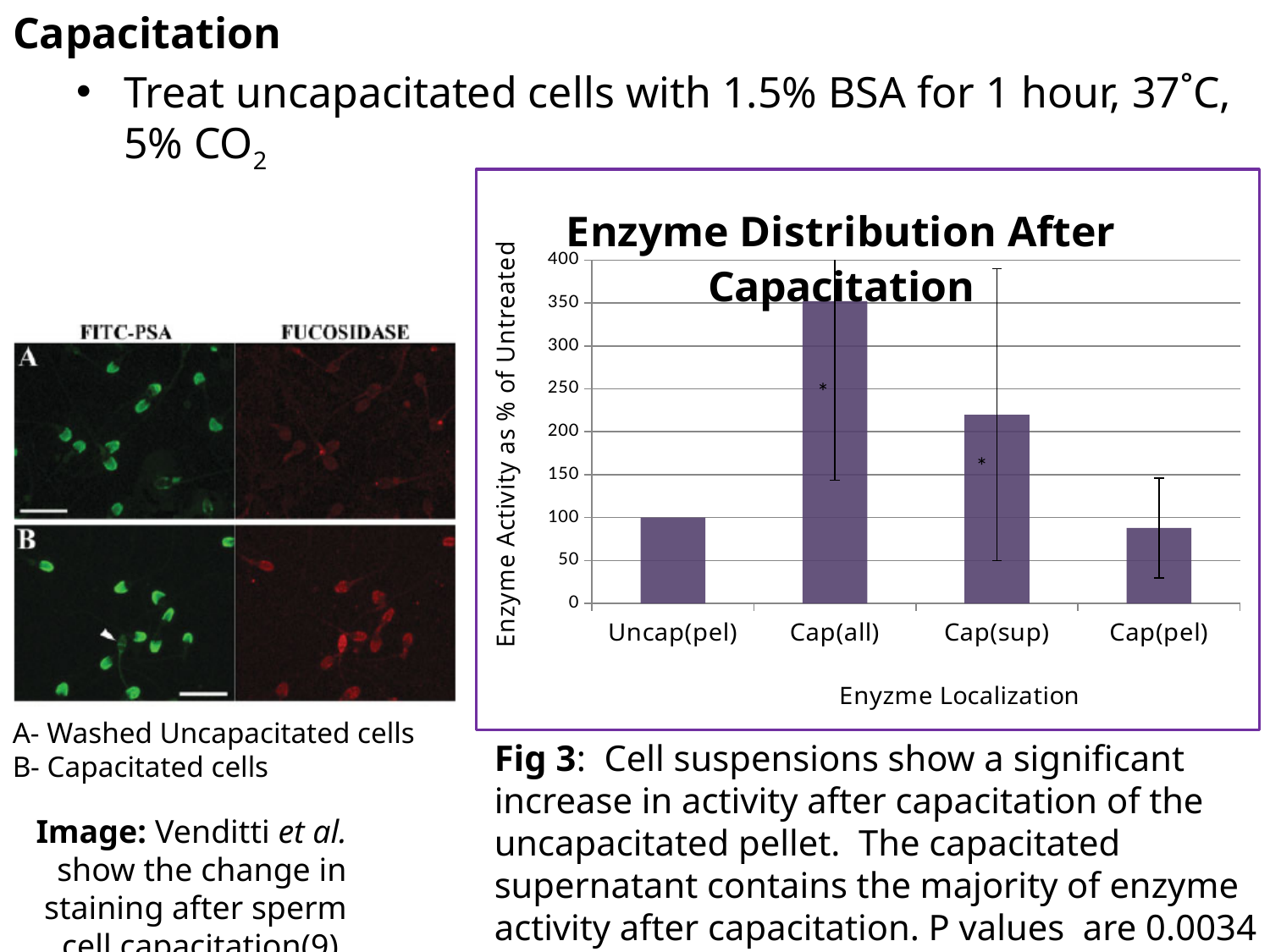
What is the title of the chart? Enzyme Distribution After Capacitation What is the label of the y axis of the chart? Enzyme Activity as % of Untreated Which category has the lowest enzyme activity in the chart? Cap(pel) Is the value for Cap(pel) greater or less than 100? less What is the enzyme activity value for Uncap(pel)? 100 Which has a larger value, Cap(all) or Cap(sup)? Cap(all) Is the value for Cap(all) greater or less than 300? greater How many categories are plotted on the x axis of the chart? 4 Which has a larger value, Uncap(pel) or Cap(sup)? Cap(sup) Is the value for Cap(sup) greater or less than 150? greater Which category has the highest enzyme activity in the chart? Cap(all) What type of chart is shown on the slide? bar chart